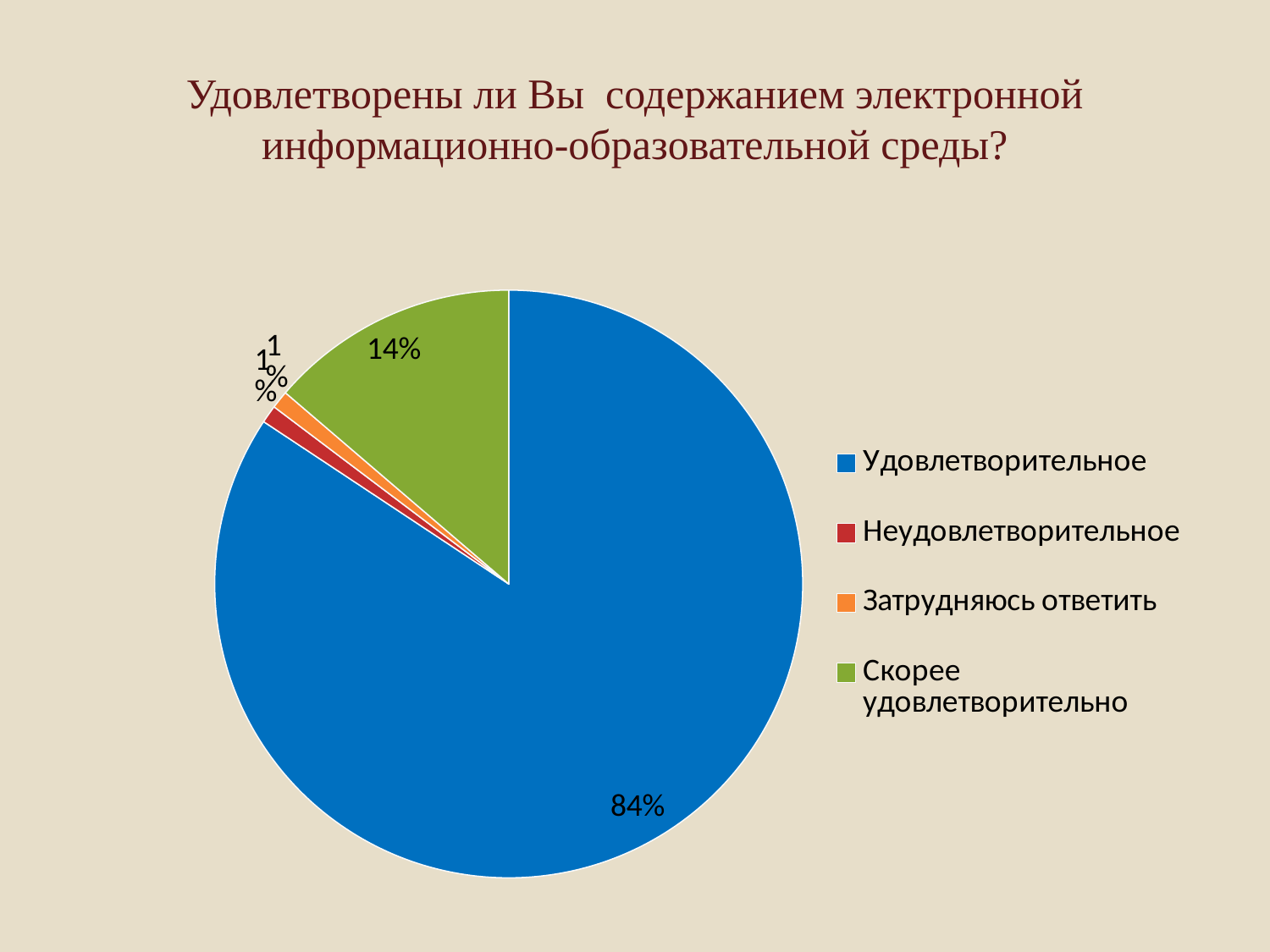
What kind of chart is shown on the slide? Pie chart What is the difference in percentage points between "Удовлетворительное" and "Скорее удовлетворительно"? 70 Which category has the largest slice of the pie? Удовлетворительное What is the combined share of "Удовлетворительное" and "Скорее удовлетворительно"? 98% What share of the pie does "Затрудняюсь ответить" take? 1% What share of the pie does "Скорее удовлетворительно" take? 14% Which legend entry is shown in red? Неудовлетворительное What share of the pie does "Удовлетворительное" take? 84% Which is larger, the slice for "Скорее удовлетворительно" or the slice for "Неудовлетворительное"? Скорее удовлетворительно What colour is the slice for "Скорее удовлетворительно"? Green How many categories does the pie chart show? 4